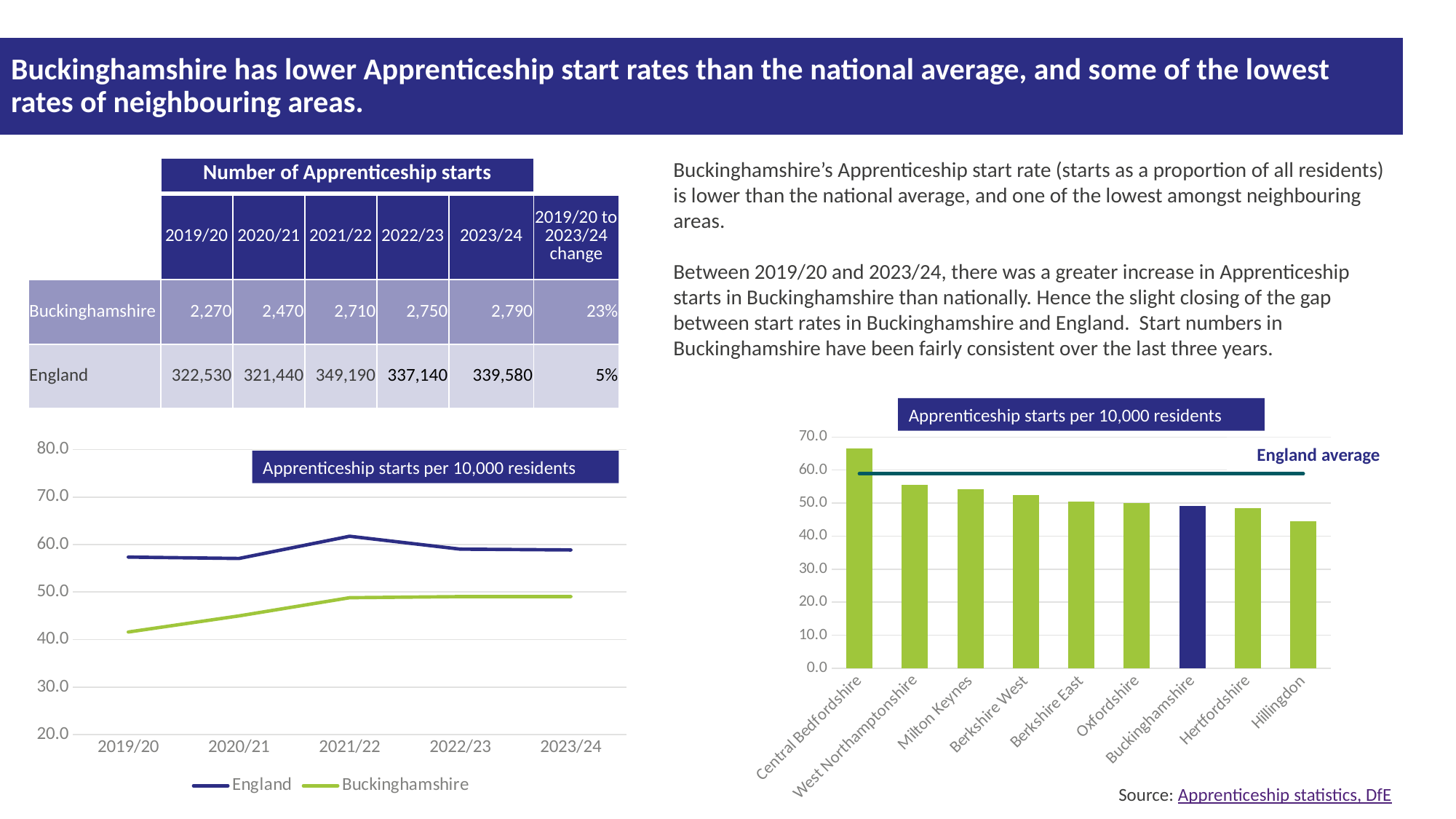
In the bar chart on the right, which has the larger value, Central Bedfordshire or Hillingdon? Central Bedfordshire In the bar chart on the right, is the value for Hillingdon greater or less than 50? less What kind of chart is the 'Apprenticeship starts per 10,000 residents' chart on the right of the slide? bar chart In the bar chart on the right, which area has the lowest apprenticeship starts per 10,000 residents? Hillingdon In the line chart on the left, how many series does the legend list? 2 In the bar chart on the right, is the value for Central Bedfordshire greater or less than 60? greater In the bar chart on the right, which area has the highest apprenticeship starts per 10,000 residents? Central Bedfordshire In the bar chart on the right, how many areas are shown? 9 What kind of chart is the 'Apprenticeship starts per 10,000 residents' chart on the left of the slide? line chart In the line chart on the left, is the value for Buckinghamshire in 2019/20 greater or less than 50? less In the line chart on the left, does the Buckinghamshire line rise or fall from 2019/20 to 2023/24? rise In the bar chart on the right, what does the horizontal line across the bars represent? England average